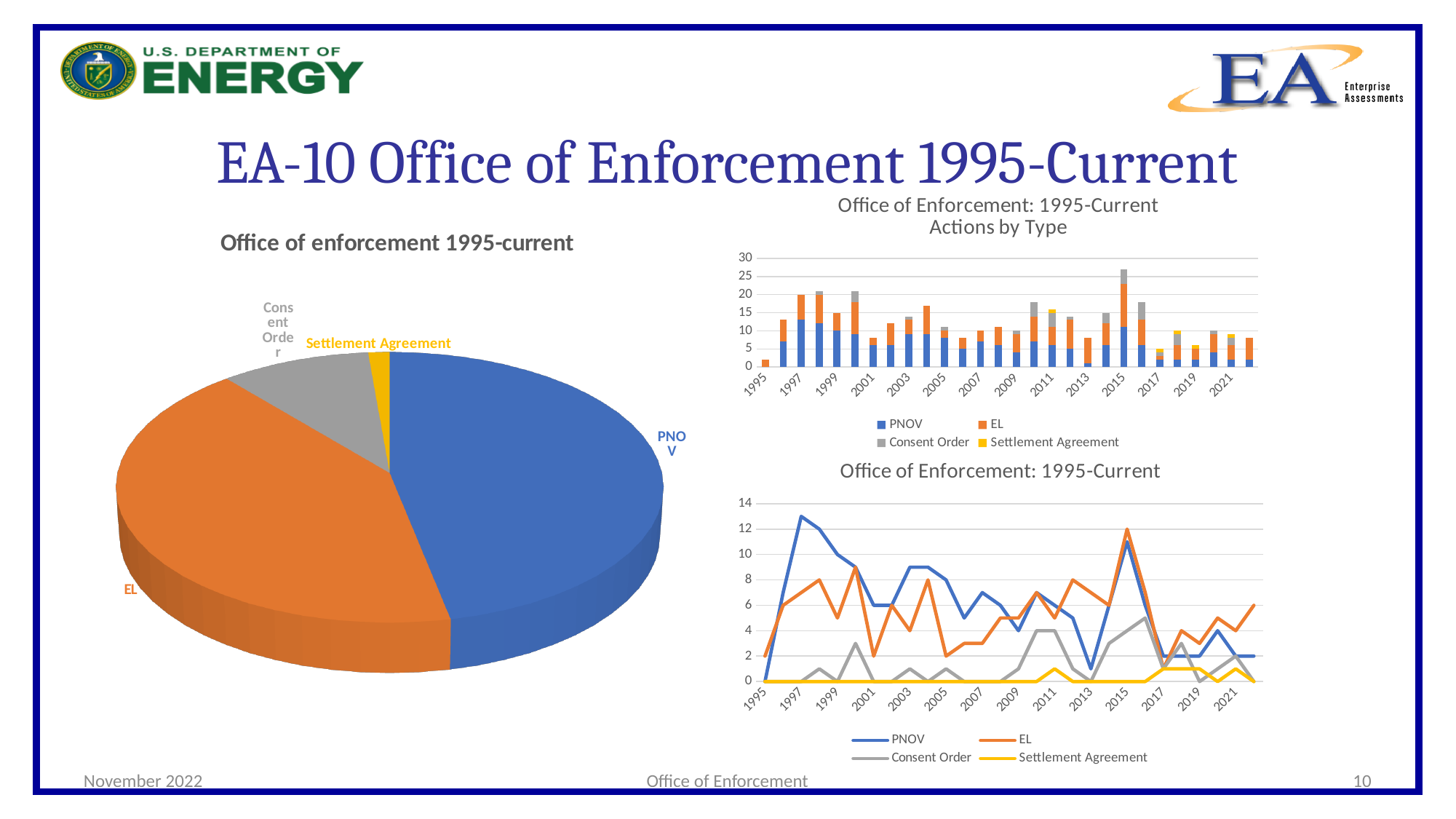
In the pie chart 'Office of enforcement 1995-current', which category has the smallest slice? Settlement Agreement How many series does the legend of the 'Office of Enforcement: 1995-Current Actions by Type' bar chart list? 4 What kind of chart is the chart titled 'Office of enforcement 1995-current' on the left of the slide? pie chart In the 'Office of Enforcement: 1995-Current' line chart, which is larger in 1997, PNOV or EL? PNOV How many slices does the pie chart 'Office of enforcement 1995-current' have? 4 In the 'Office of Enforcement: 1995-Current' line chart, is the PNOV value for 1997 greater or less than 12? greater In the 'Office of Enforcement: 1995-Current Actions by Type' bar chart, which year has the tallest stacked bar? 2015 In the 'Office of Enforcement: 1995-Current' line chart, in which year does the PNOV line reach its highest value? 1997 In the 'Office of Enforcement: 1995-Current' line chart, what is the PNOV value for 1995? 0 In the 'Office of Enforcement: 1995-Current Actions by Type' bar chart, is the total for 2015 greater or less than 25? greater What kind of chart is the 'Office of Enforcement: 1995-Current Actions by Type' chart at the top right? bar chart What kind of chart is the 'Office of Enforcement: 1995-Current' chart at the bottom right? line chart